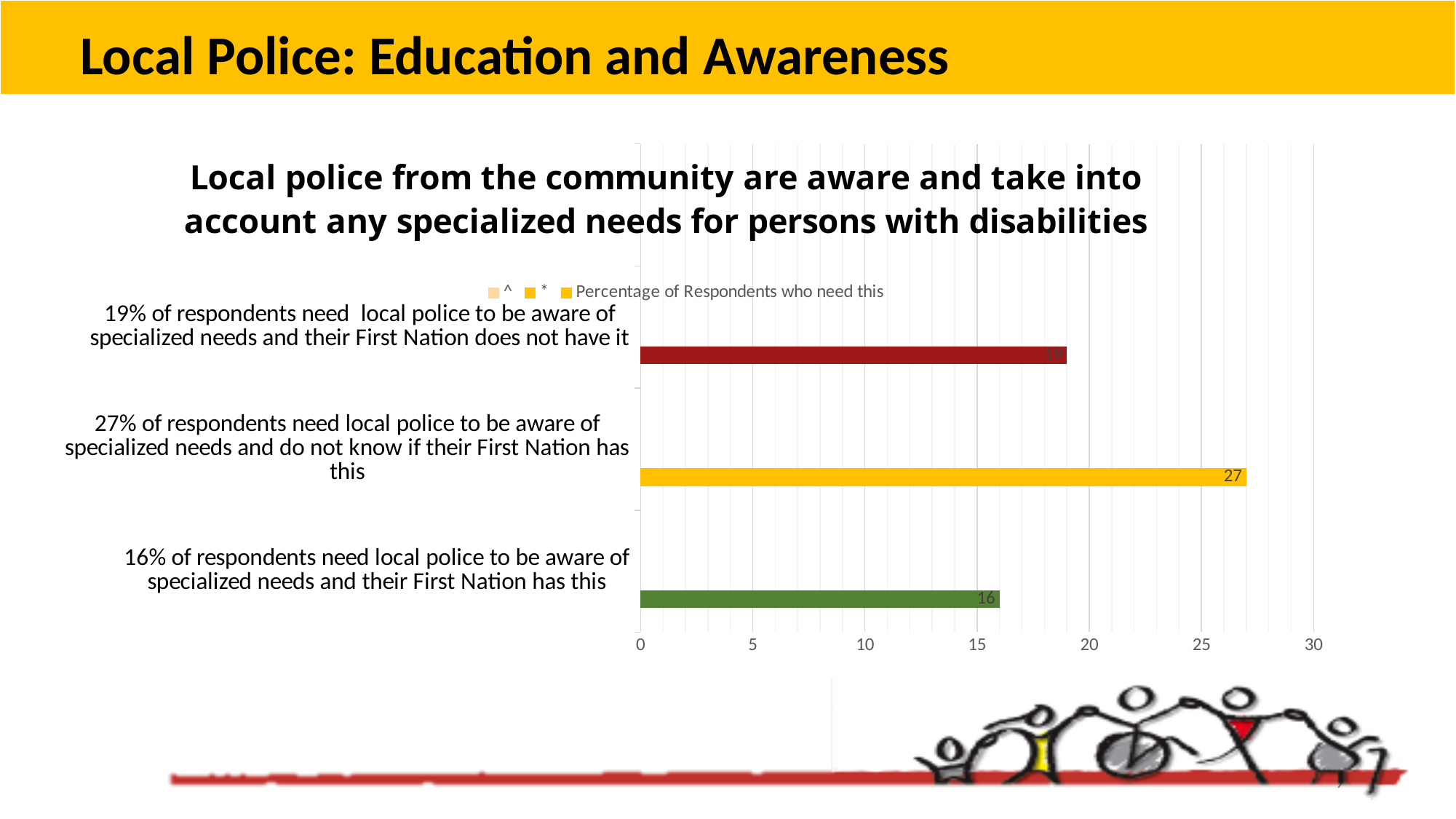
What kind of chart is shown on the slide? bar chart Which category has the lowest value? 16% of respondents need local police to be aware of specialized needs and their First Nation has this Which is larger: the value for those whose First Nation does not have it or the value for those who do not know if their First Nation has this? do not know if their First Nation has this How many bars are plotted in the chart? 3 What is the difference between the value for those whose First Nation does not have it and those whose First Nation has this? 3 What colour is the bar for respondents who do not know if their First Nation has this? yellow What is the difference between the value for those who do not know if their First Nation has this and those whose First Nation has this? 11 Which category has the highest value? 27% of respondents need local police to be aware of specialized needs and do not know if their First Nation has this What is the value for respondents whose First Nation has this? 16 What is the value for respondents whose First Nation does not have it? 19 What is the value for respondents who do not know if their First Nation has this? 27 How many entries does the legend list? 3